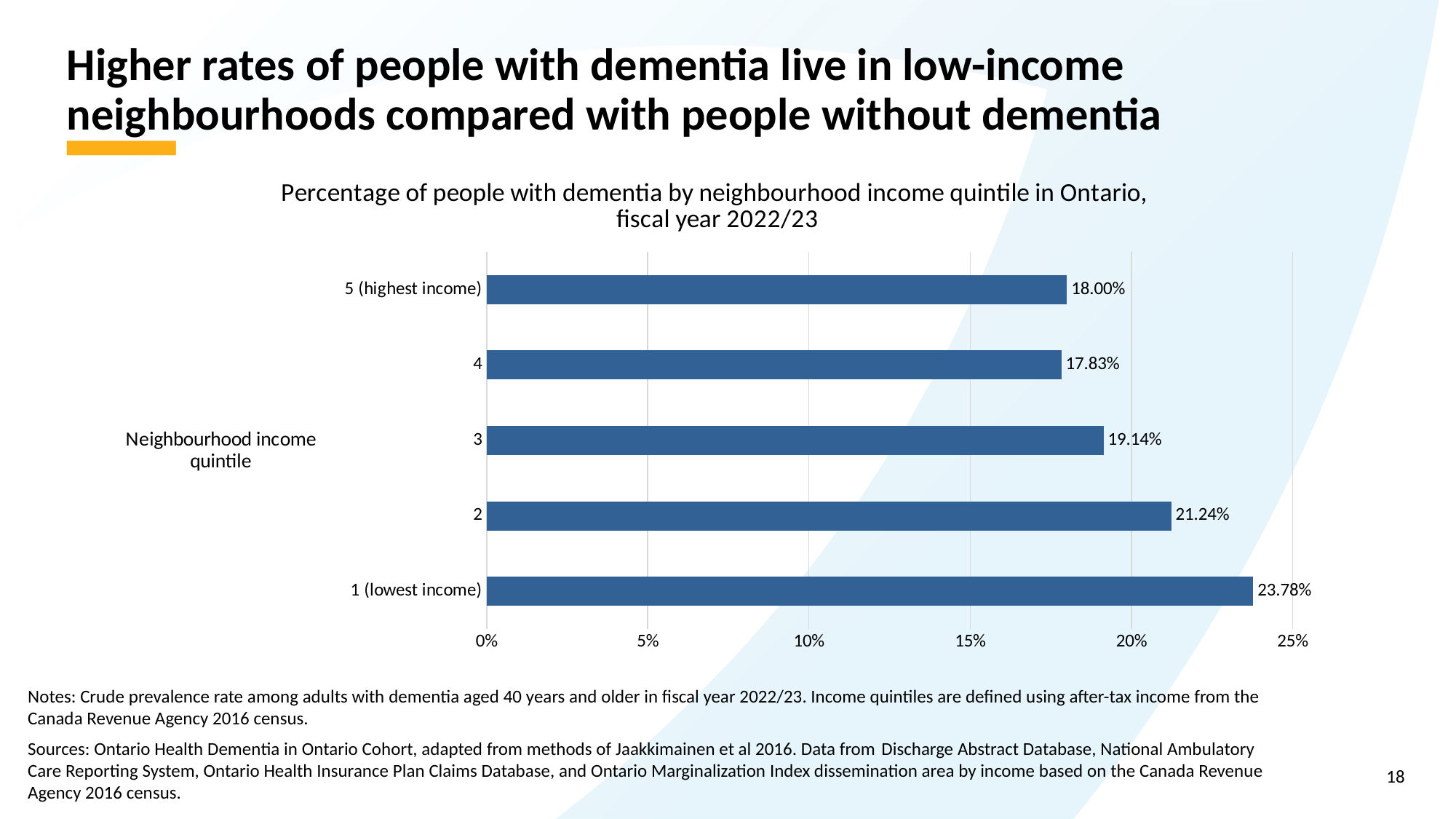
Which has a larger value, quintile 2 or quintile 4? 2 How many neighbourhood income quintiles are shown in the chart? 5 What is the difference between the values for quintile 2 and quintile 3? 2.10% What is the value for neighbourhood income quintile 3? 19.14% Which neighbourhood income quintile has the highest percentage of people with dementia? 1 (lowest income) Is the value for quintile 1 (lowest income) greater or less than 20%? greater What is the title of the chart? Percentage of people with dementia by neighbourhood income quintile in Ontario, fiscal year 2022/23 What kind of chart is shown on the slide? Bar chart What is the difference between the values for quintile 1 (lowest income) and quintile 5 (highest income)? 5.78% Which neighbourhood income quintile has the lowest percentage of people with dementia? 4 What is the value for neighbourhood income quintile 5 (highest income)? 18.00% What percentage of people with dementia live in neighbourhood income quintile 1 (lowest income)? 23.78%